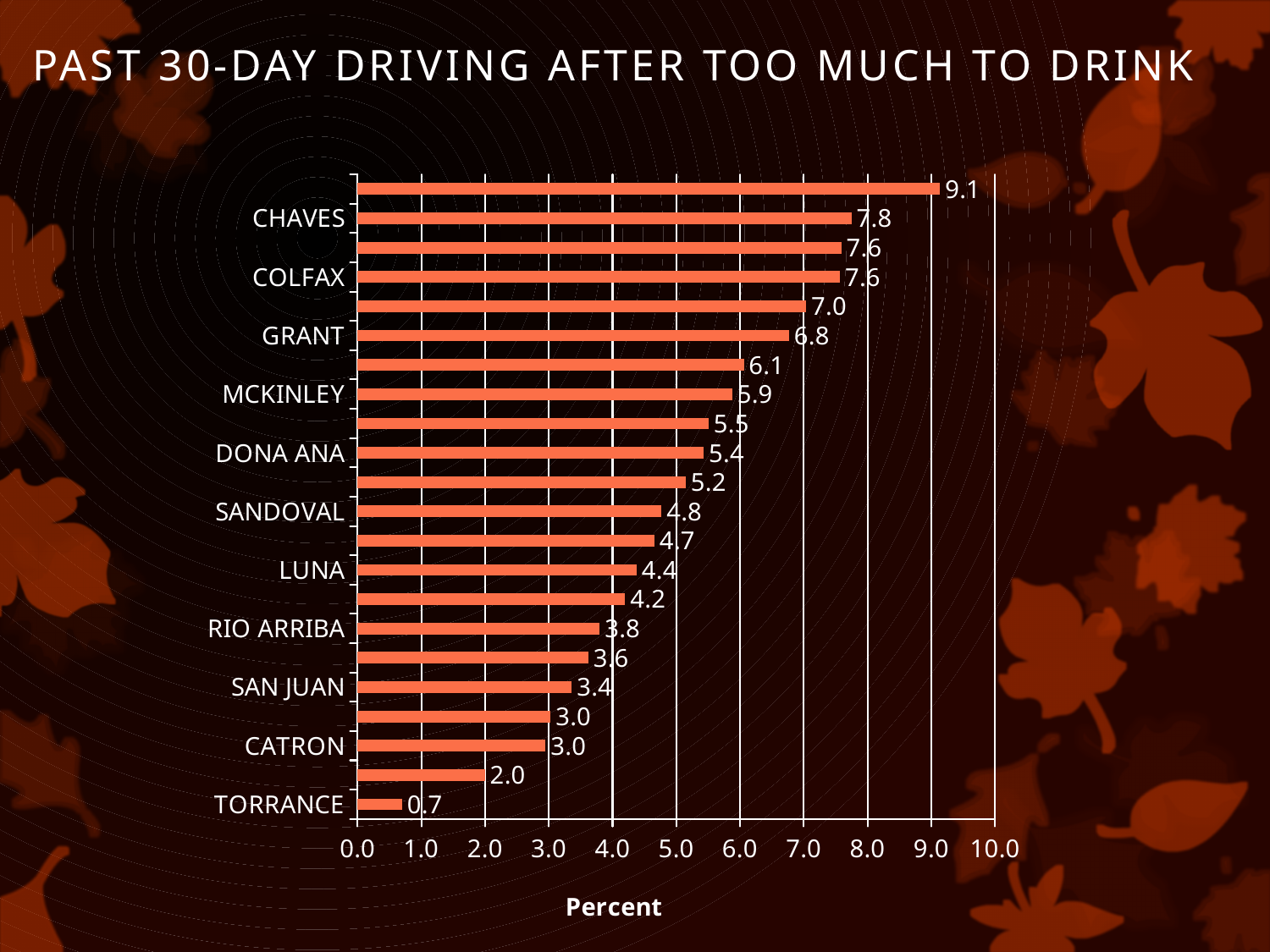
What kind of chart is shown on the slide? bar chart What is the difference between the values for CHAVES and COLFAX? 0.2 What is the highest value shown on the chart? 9.1 Is the value for LUNA greater or less than 5.0? less How many bars are plotted on the chart? 22 What is the value for GRANT? 6.8 Which labeled county has the lowest value? TORRANCE What is the value for CHAVES? 7.8 What is the value for SANDOVAL? 4.8 What is the title of the horizontal axis? Percent Which has a larger value, MCKINLEY or DONA ANA? MCKINLEY What is the value for SAN JUAN? 3.4